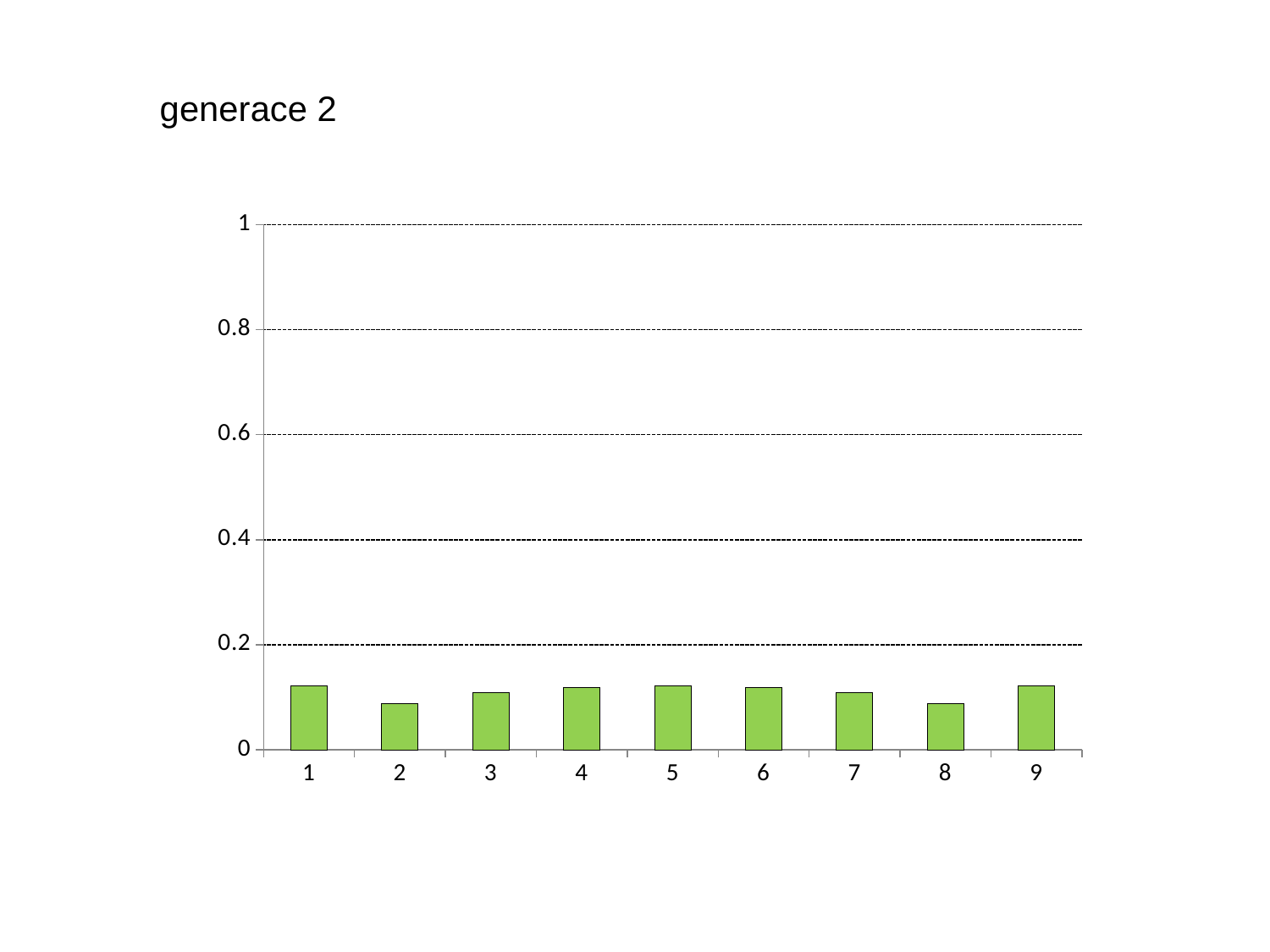
Is the value for category 5 greater or less than 0.2? less Is the value for category 1 greater or less than 0.2? less Which is larger, the value for category 1 or the value for category 2? 1 How many categories are plotted on the x axis? 9 What is the title text shown on the slide above the chart? generace 2 Are any of the bars greater than 0.2? no Which is larger, the value for category 8 or the value for category 9? 9 Which is larger, the value for category 2 or the value for category 5? 5 What is the highest value shown on the y axis? 1 What kind of chart is shown on the slide? bar chart